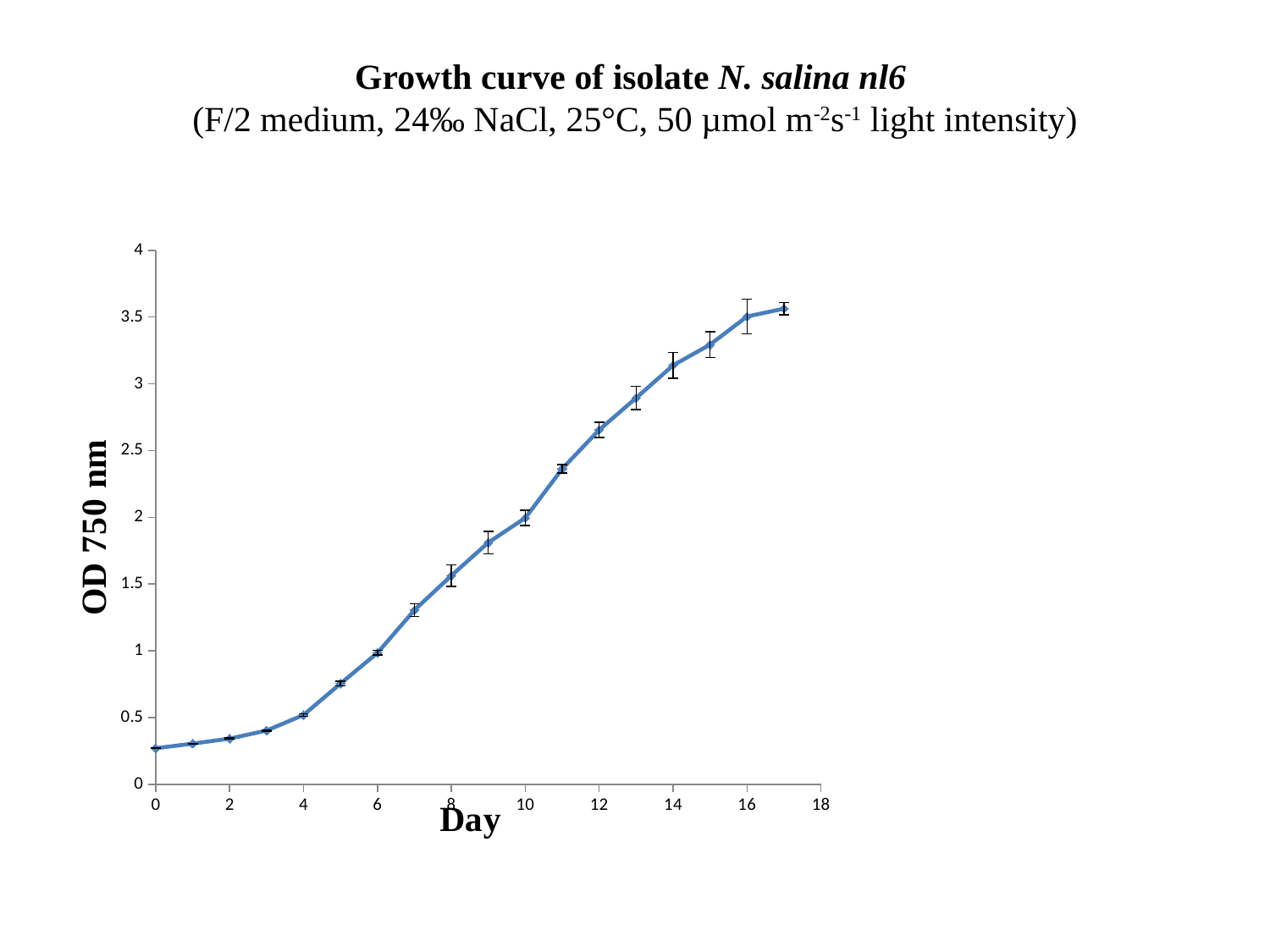
Does the OD 750 nm value rise or fall as the day increases along the x axis? rise Is the OD 750 nm value on day 7 greater or less than 1.5? less What is the label of the x axis? Day Which day has the larger OD 750 nm value, day 9 or day 13? day 13 How many data points are plotted on the growth curve? 18 On which day is the OD 750 nm value lowest? 0 Is the OD 750 nm value on day 5 greater or less than 0.5? greater On which day is the OD 750 nm value highest? 17 What kind of chart is shown on the slide? line chart Is the OD 750 nm value on day 14 greater or less than 3? greater What is the label of the y axis? OD 750 nm